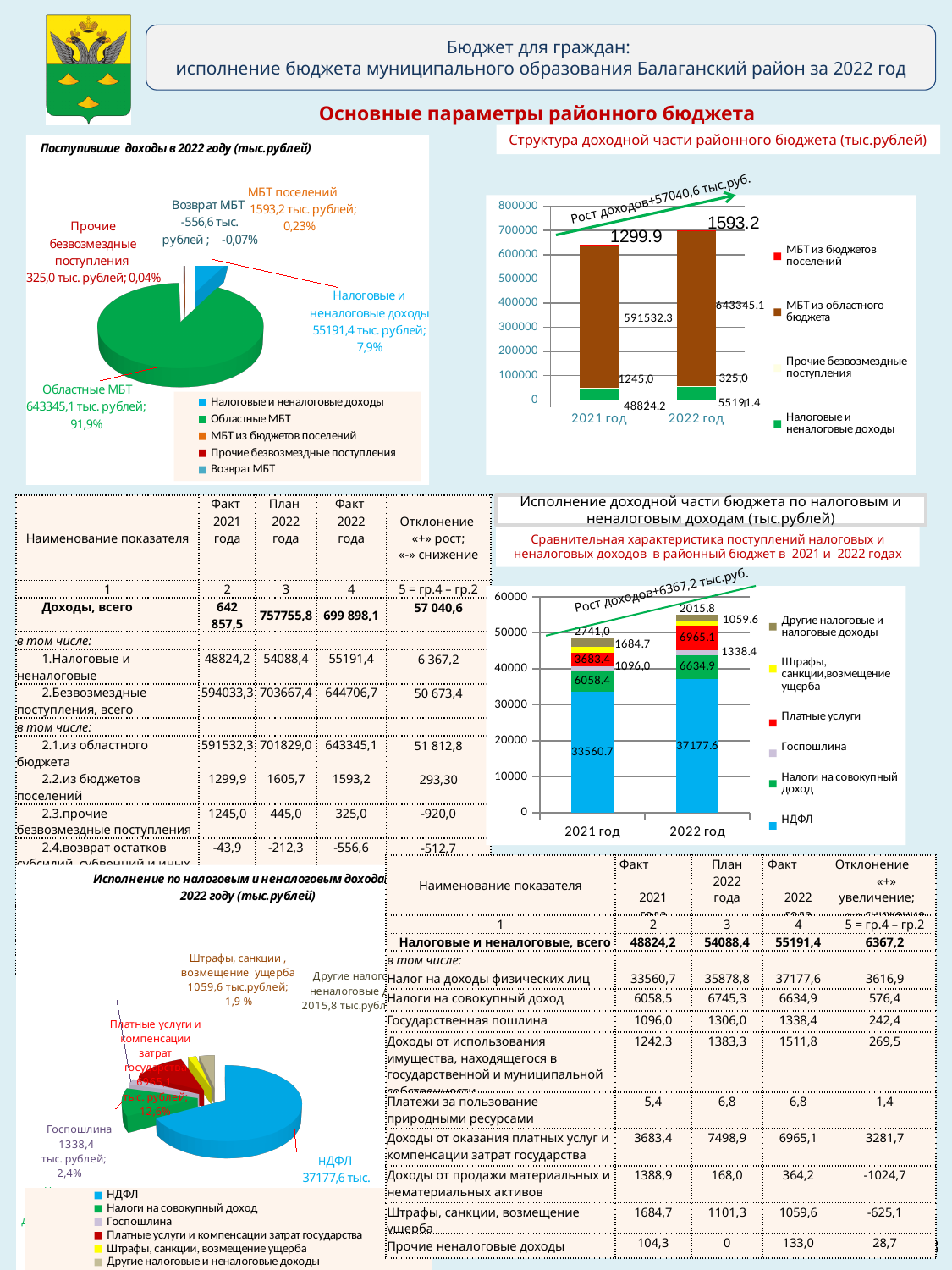
In the middle-right chart comparing tax and non-tax revenues in 2021 and 2022, which year has the larger 'НДФЛ' value? 2022 год How many entries does the legend of the top-left pie chart 'Поступившие доходы в 2022 году' list? 5 In the middle-right chart comparing tax and non-tax revenues in 2021 and 2022, what is the value of 'Платные услуги' for 2021 год? 3683.4 In the top-left pie chart 'Поступившие доходы в 2022 году', what value is shown for 'Налоговые и неналоговые доходы'? 55191,4 тыс. рублей In the top-right chart 'Структура доходной части районного бюджета', what is the value of 'Налоговые и неналоговые доходы' for 2021 год? 48824.2 In the top-left pie chart 'Поступившие доходы в 2022 году', what share is shown for 'Областные МБТ'? 91,9% In the top-right chart 'Структура доходной части районного бюджета', how many year categories are shown on the x axis? 2 In the top-right chart 'Структура доходной части районного бюджета', what is the value of 'МБТ из областного бюджета' for 2022 год? 643345.1 In the middle-right chart comparing tax and non-tax revenues in 2021 and 2022, what is the value of 'НДФЛ' for 2022 год? 37177.6 How many series does the legend of the middle-right chart comparing tax and non-tax revenues list? 6 What type of chart is the top-right chart 'Структура доходной части районного бюджета'? stacked bar chart In the bottom-left pie chart 'Исполнение по налоговым и неналоговым доходам в 2022 году', what share is shown for 'Госпошлина'? 2,4%